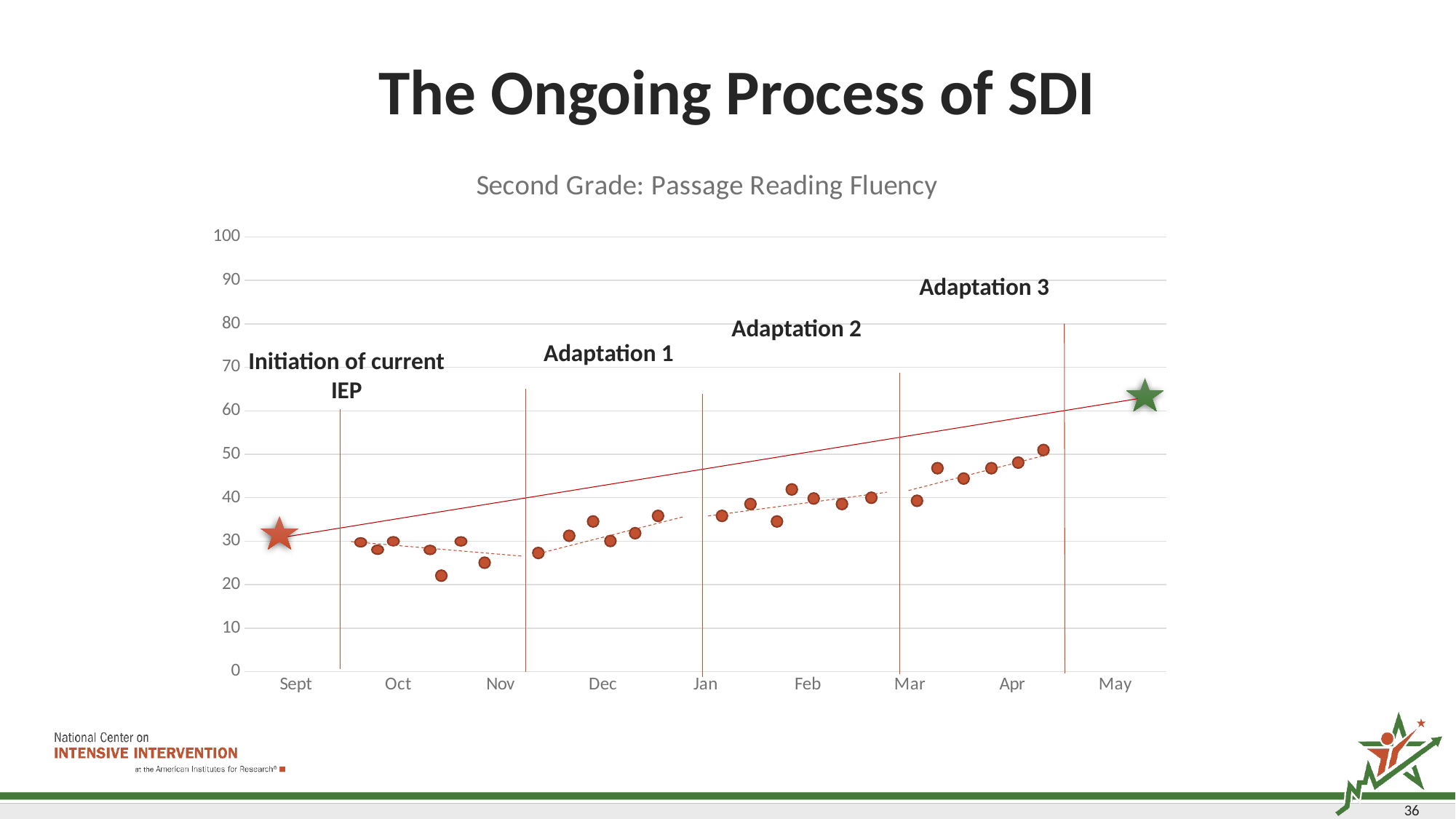
Between the initiation of the current IEP and Adaptation 1, does the dashed trend line of the data points rise or fall? Fall Overall, do the plotted data points rise or fall from Sept to Apr? Rise Is the lowest data point in October greater or less than 30? less Is the first data point after Adaptation 1 (in late November) greater or less than 30? less What is the title of the chart? Second Grade: Passage Reading Fluency How many adaptations are annotated on the chart? 3 What is the maximum value shown on the y axis? 100 Is the highest data point in April greater or less than 40? greater Are the data points in April higher or lower than the data points in October? Higher What kind of chart is shown on the slide? Line chart How many months are labelled on the x axis of the chart? 9